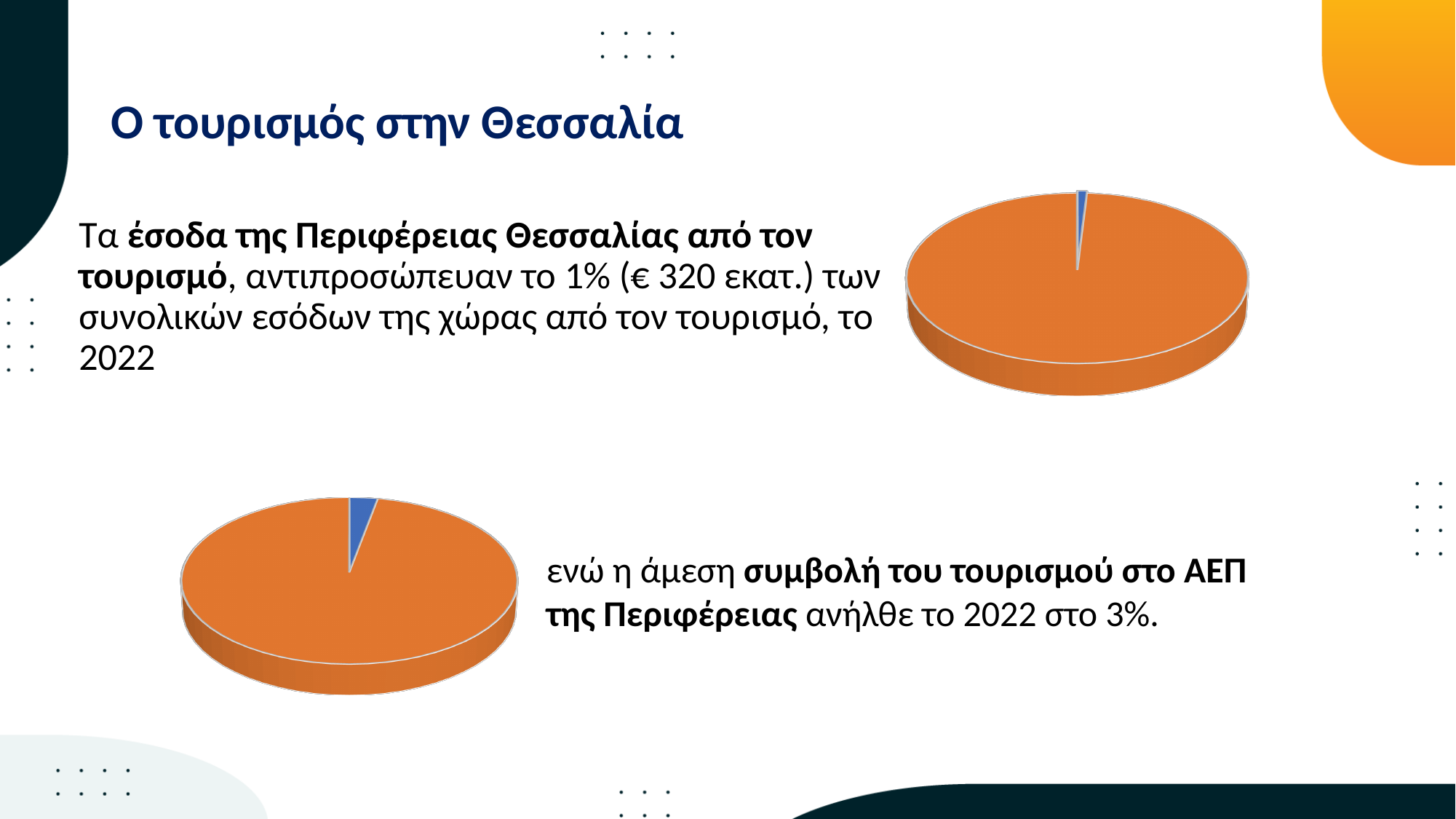
What kind of chart is shown at the bottom left of the slide? pie chart In the top-right pie chart, which slice is larger, the orange one or the blue one? orange In the top-right pie chart, what colour is the smallest slice? blue In the bottom-left pie chart, how many slices are there? 2 In the bottom-left pie chart, which slice is larger, the orange one or the blue one? orange What kind of chart is shown at the top right of the slide? pie chart Does the top-right pie chart display a legend? No How many pie charts are on the slide? 2 In the bottom-left pie chart, what colour is the largest slice? orange In the top-right pie chart, how many slices are there? 2